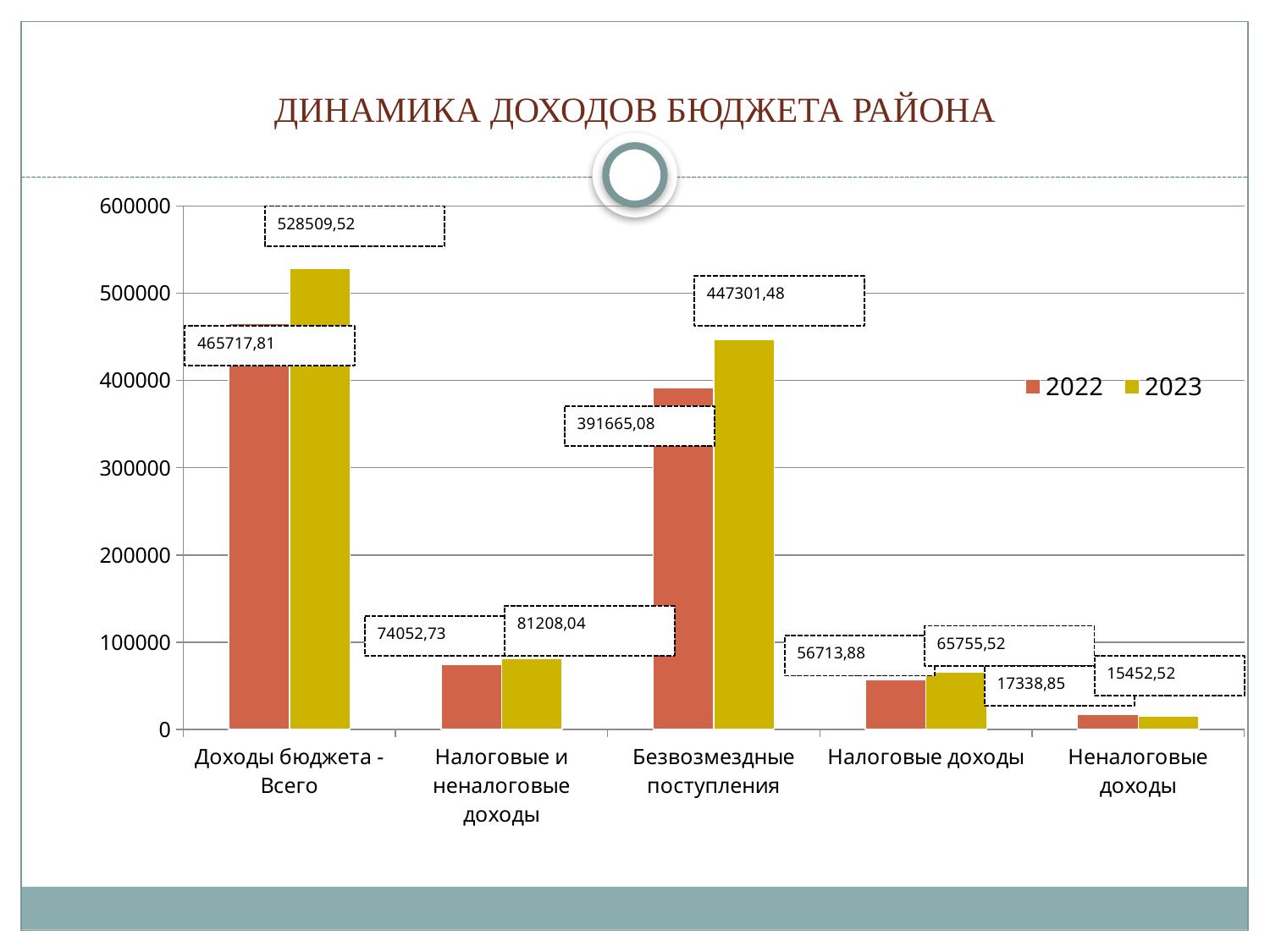
What type of chart is shown on the slide? Bar chart For Налоговые и неналоговые доходы, which year has the larger value, 2022 or 2023? 2023 What is the difference between the 2023 and 2022 values for Доходы бюджета - Всего? 62791,71 What is the 2023 value for Доходы бюджета - Всего? 528509,52 What is the 2022 value for Безвозмездные поступления? 391665,08 Which category has the lowest 2023 value? Неналоговые доходы How many series does the legend list? 2 How many categories are shown on the x axis? 5 What is the 2022 value for Неналоговые доходы? 17338,85 Which category has the highest 2022 value? Доходы бюджета - Всего What is the 2023 value for Налоговые доходы? 65755,52 What is the difference between the 2022 and 2023 values for Неналоговые доходы? 1886,33